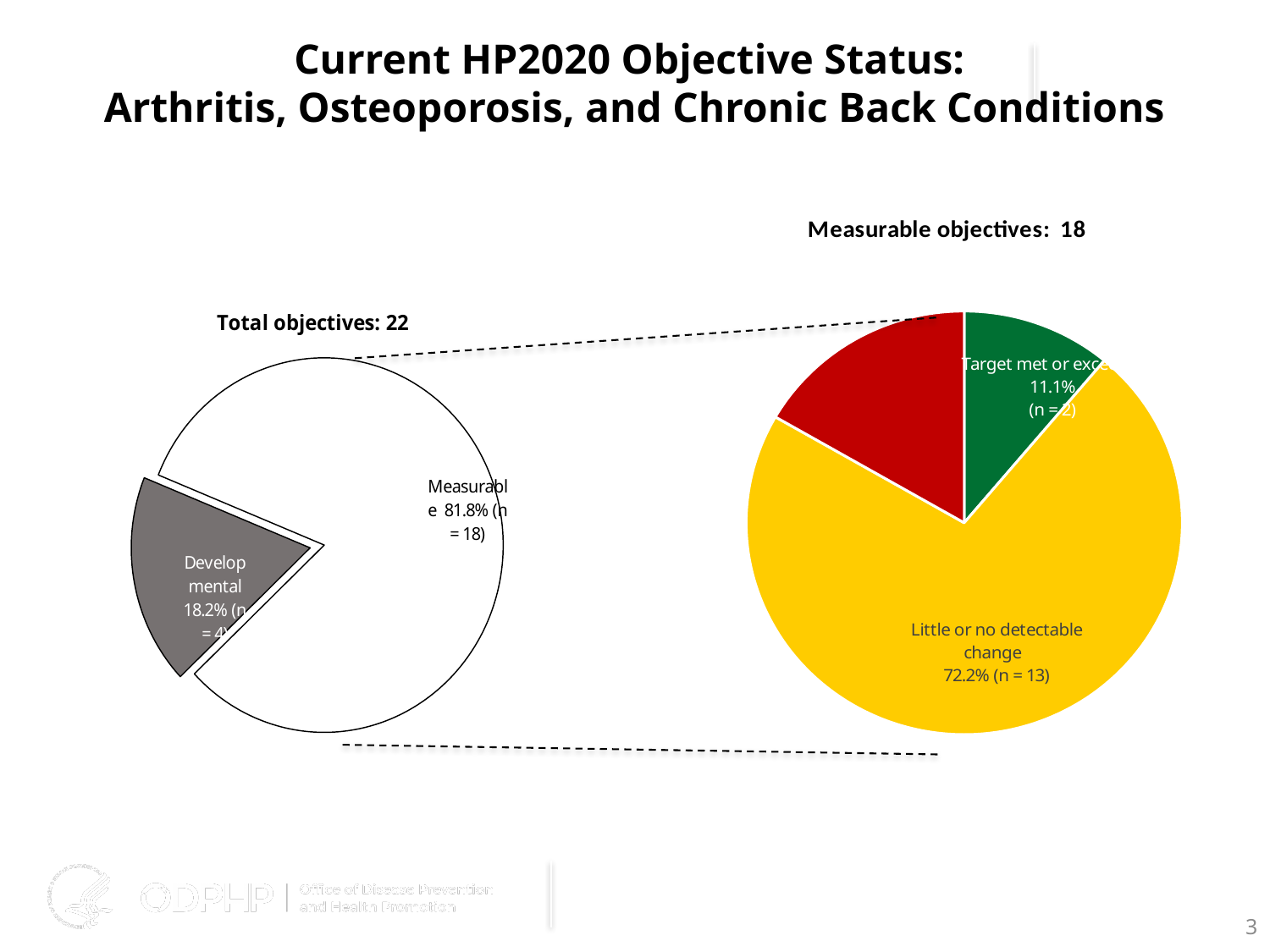
In the 'Measurable objectives: 18' pie chart, what percentage of objectives have the target met or exceeded? 11.1% In the 'Total objectives: 22' pie chart, how many slices are shown? 2 In the 'Measurable objectives: 18' pie chart, what percentage of objectives show Little or no detectable change? 72.2% In the 'Measurable objectives: 18' pie chart, which category has the largest slice? Little or no detectable change In the 'Measurable objectives: 18' pie chart, what colour is the slice for Little or no detectable change? yellow What kind of chart is used on the left side of the slide, titled 'Total objectives: 22'? pie chart In the 'Total objectives: 22' pie chart, how many objectives are Developmental? 4 In the 'Total objectives: 22' pie chart, what percentage of objectives are Developmental? 18.2% In the 'Measurable objectives: 18' pie chart, how many objectives have Little or no detectable change? 13 In the 'Total objectives: 22' pie chart, what percentage of objectives are Measurable? 81.8% In the 'Total objectives: 22' pie chart, which slice is larger, Measurable or Developmental? Measurable In the 'Measurable objectives: 18' pie chart, how many slices are shown? 3